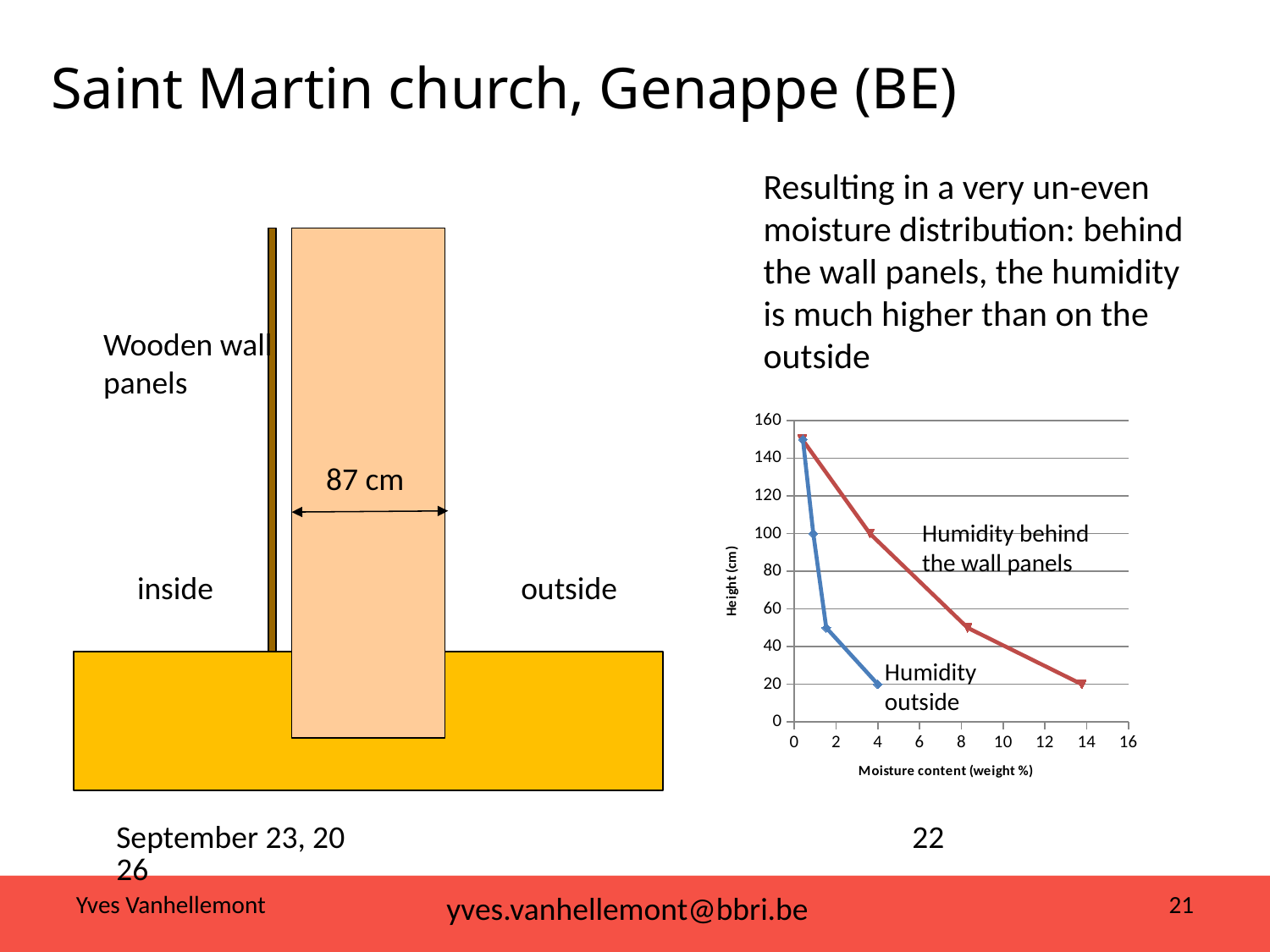
Is the moisture content for 'Humidity outside' at a height of 20 cm greater or less than 6? less Is the moisture content for 'Humidity behind the wall panels' at a height of 50 cm greater or less than 6? greater What is the label of the x axis of the chart? Moisture content (weight %) What is the label of the y axis of the chart? Height (cm) As height increases, does the moisture content for 'Humidity behind the wall panels' rise or fall? fall Is the moisture content for 'Humidity behind the wall panels' at a height of 20 cm greater or less than 12? greater How many series are plotted in the chart? 2 What kind of chart is shown on the slide? Line chart How many data points does the 'Humidity behind the wall panels' series have? 4 Which series reaches the highest moisture content in the chart? Humidity behind the wall panels At a height of 50 cm, which series has the higher moisture content? Humidity behind the wall panels